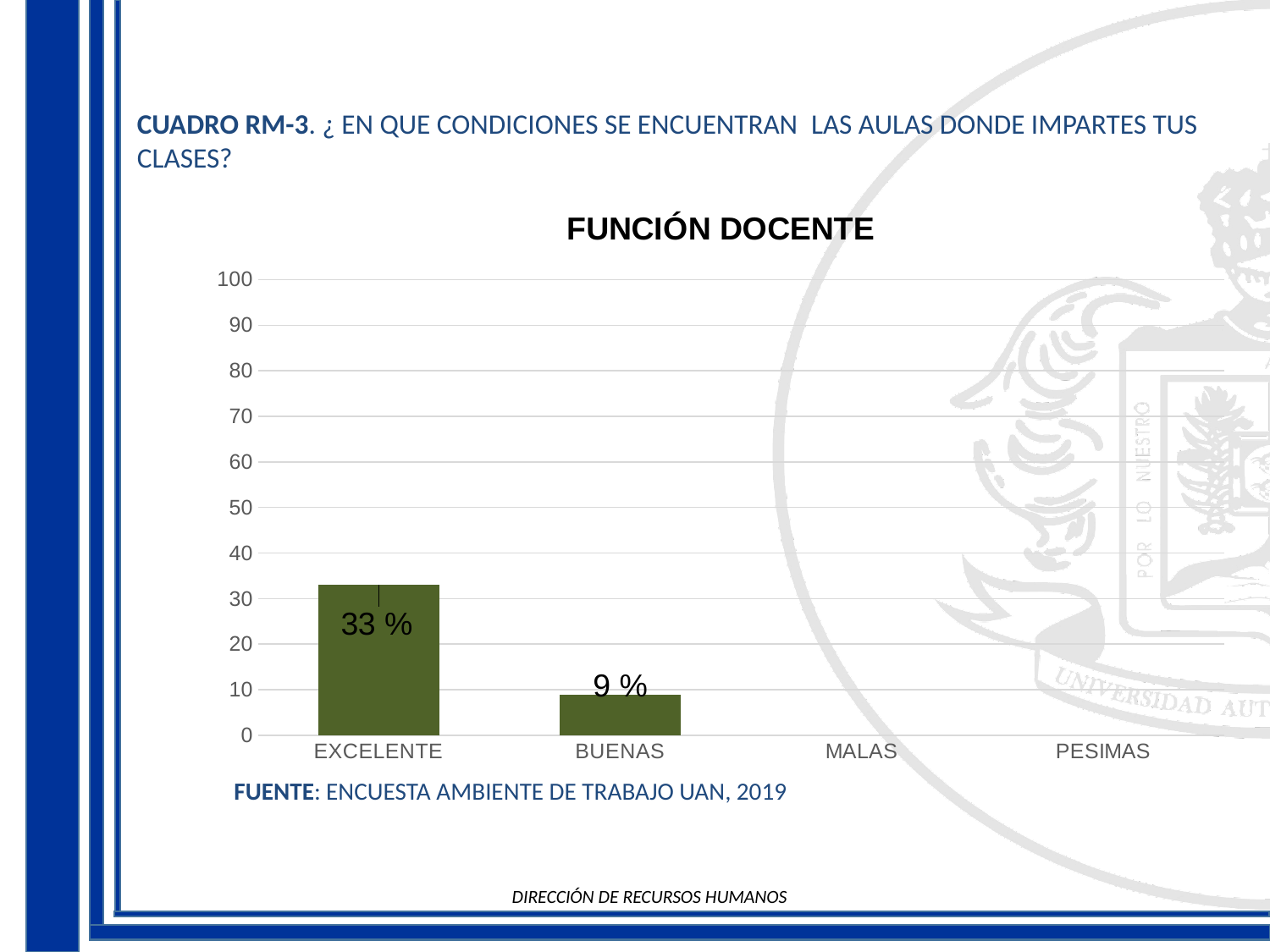
What kind of chart is the FUNCIÓN DOCENTE chart? bar chart What is the value for EXCELENTE in the FUNCIÓN DOCENTE chart? 33 % How many categories are shown on the x axis of the FUNCIÓN DOCENTE chart? 4 Do the values fall or rise from EXCELENTE to BUENAS in the FUNCIÓN DOCENTE chart? fall What is the title of the chart on the slide? FUNCIÓN DOCENTE How many categories in the FUNCIÓN DOCENTE chart have a visible bar? 2 What is the value for BUENAS in the FUNCIÓN DOCENTE chart? 9 % Which is larger in the FUNCIÓN DOCENTE chart, EXCELENTE or BUENAS? EXCELENTE Is the value for BUENAS in the FUNCIÓN DOCENTE chart greater or less than 10? less What is the difference between the values for EXCELENTE and BUENAS in the FUNCIÓN DOCENTE chart? 24 % Is the value for EXCELENTE in the FUNCIÓN DOCENTE chart greater or less than 30? greater Which category has the highest value in the FUNCIÓN DOCENTE chart? EXCELENTE